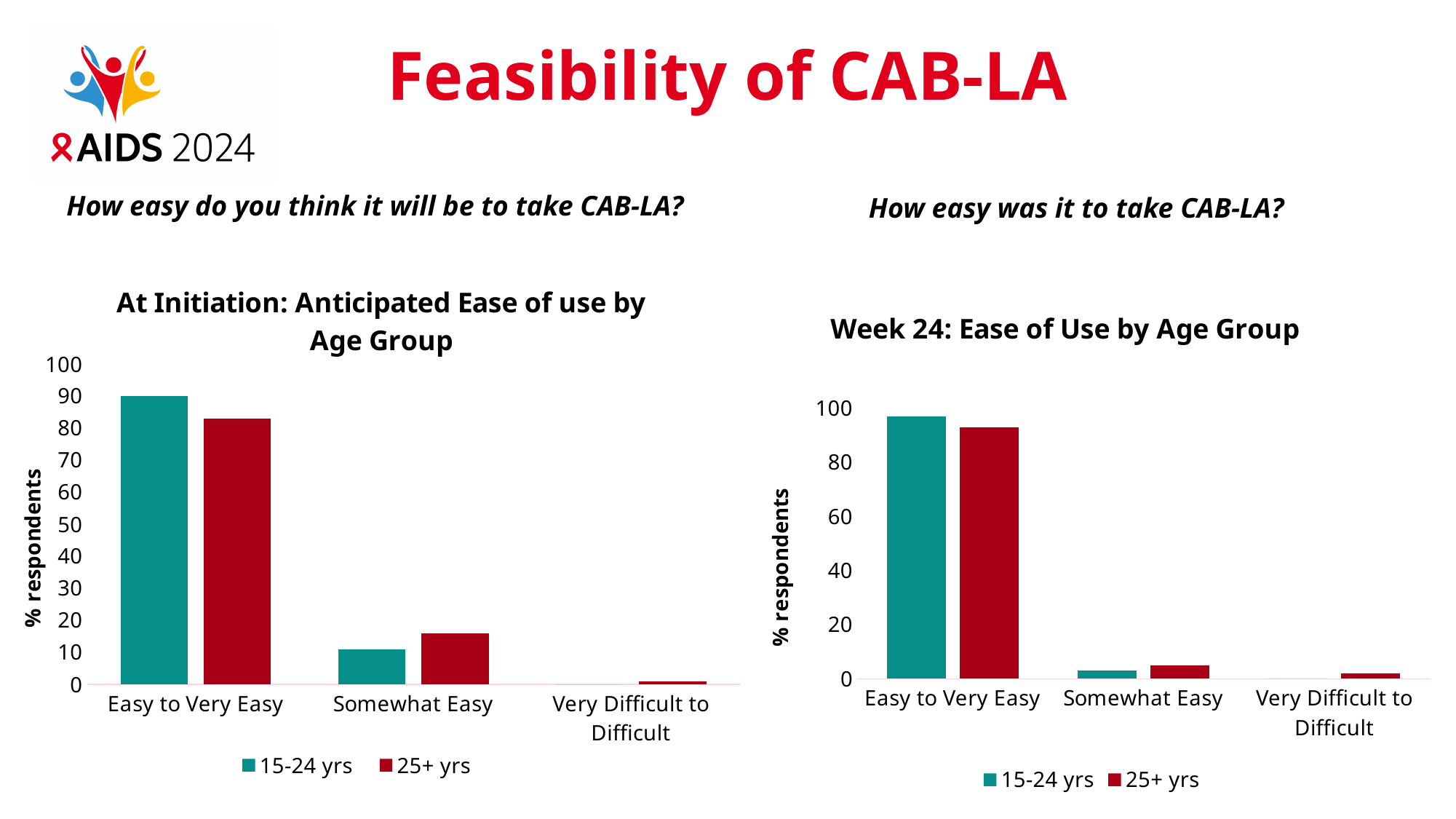
What type of chart is the 'At Initiation: Anticipated Ease of use by Age Group' chart? bar chart What is the y-axis label of the 'Week 24: Ease of Use by Age Group' chart? % respondents In the 'Week 24: Ease of Use by Age Group' chart, which category has the lowest value for 25+ yrs? Very Difficult to Difficult In the 'At Initiation: Anticipated Ease of use by Age Group' chart, which category has the highest value for 15-24 yrs? Easy to Very Easy In the 'Week 24: Ease of Use by Age Group' chart, is the value for 15-24 yrs in 'Somewhat Easy' greater or less than 20? less How many categories are shown on the x axis of the 'At Initiation: Anticipated Ease of use by Age Group' chart? 3 How many series does the legend list in the 'Week 24: Ease of Use by Age Group' chart? 2 In the 'At Initiation: Anticipated Ease of use by Age Group' chart, is the value for 15-24 yrs in 'Easy to Very Easy' greater or less than 80? greater In the 'Week 24: Ease of Use by Age Group' chart, which is larger for 'Easy to Very Easy': 15-24 yrs or 25+ yrs? 15-24 yrs In the 'Week 24: Ease of Use by Age Group' chart, is the value for 25+ yrs in 'Easy to Very Easy' greater or less than 80? greater In the 'At Initiation: Anticipated Ease of use by Age Group' chart, which is larger for 'Somewhat Easy': 15-24 yrs or 25+ yrs? 25+ yrs